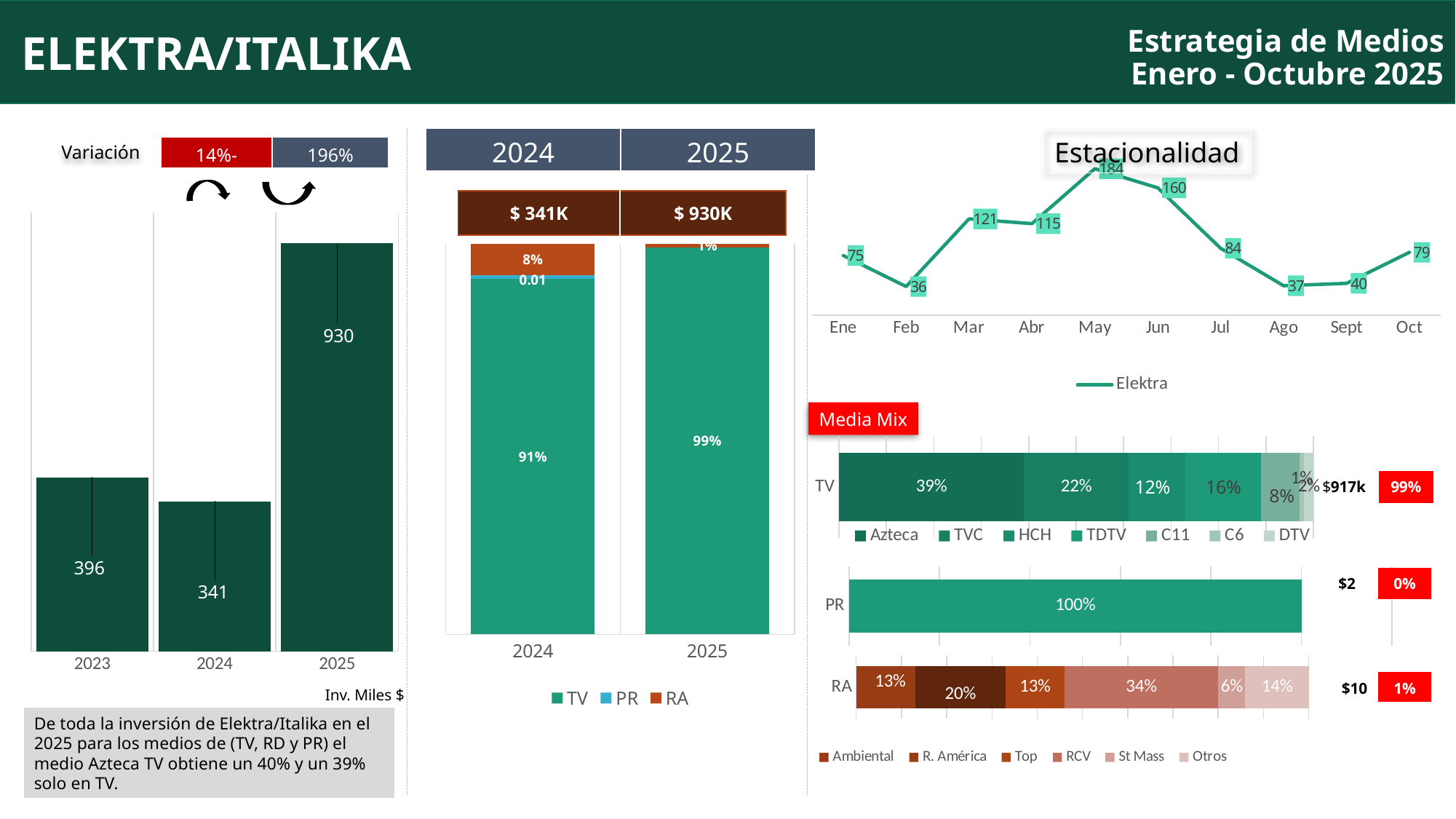
In the left bar chart of investment by year, which year has the lowest value? 2024 In the middle stacked bar chart of 2024 vs 2025, how many series does the legend list? 3 In the Estacionalidad chart, what kind of chart is it? Line chart In the middle stacked bar chart of 2024 vs 2025, what share does TV have in 2025? 99% In the left bar chart of investment by year, what is the value for 2025? 930 In the left bar chart of investment by year, what is the difference between the 2025 and 2024 values? 589 In the left bar chart of investment by year, what is the value for 2023? 396 In the Estacionalidad line chart, what is the value for May? 184 In the Media Mix chart, what is the share of RCV in the RA bar? 34% In the Estacionalidad line chart, what is the difference between the Jun and Jul values? 76 In the Estacionalidad line chart, how many months are plotted? 10 In the Estacionalidad line chart, which month has the lowest value? Feb